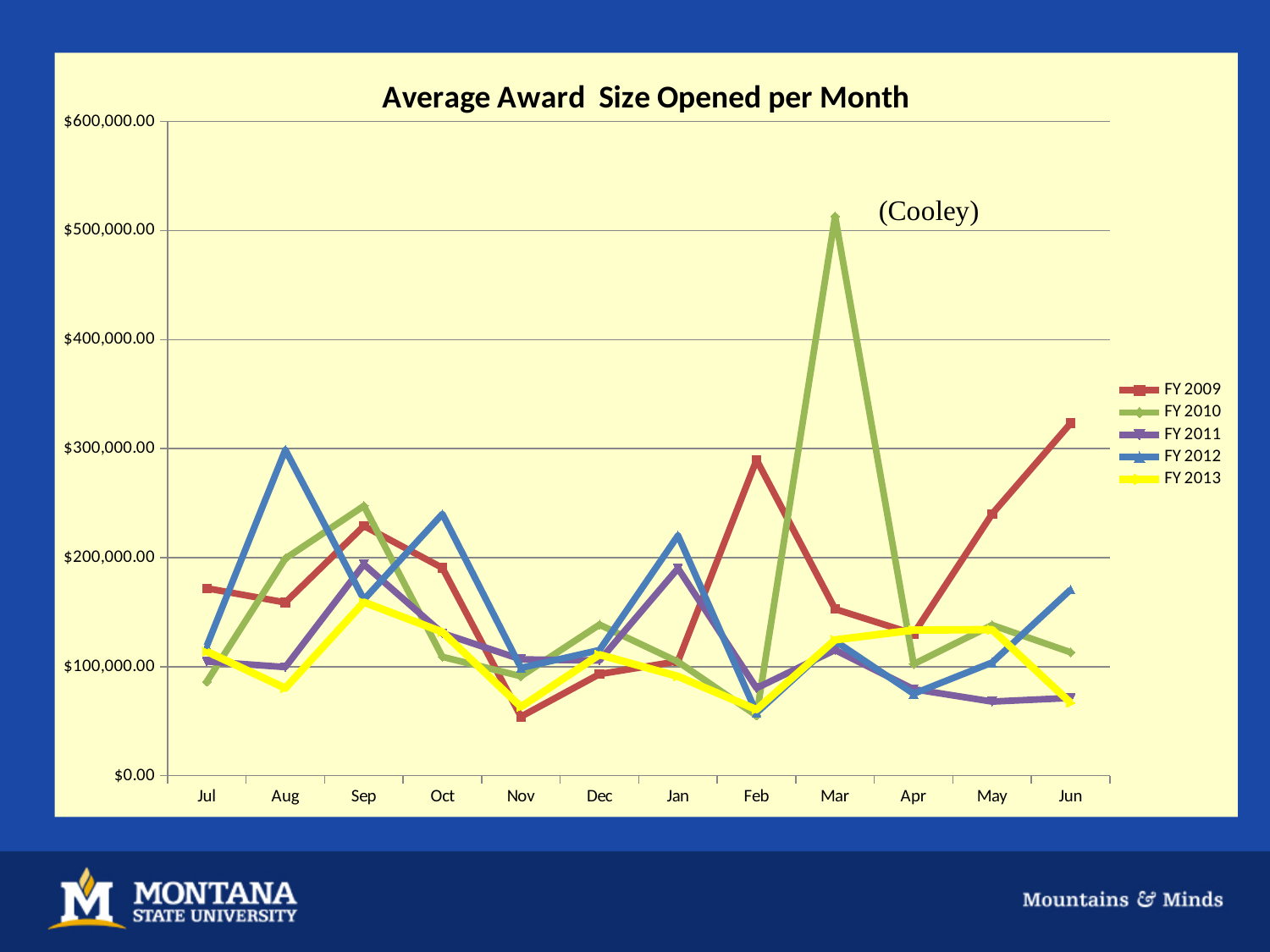
Is the FY 2010 value for Mar greater or less than $400,000.00? greater Which series reaches the highest value anywhere on the chart? FY 2010 What kind of chart is shown on the slide? line chart In which month does the FY 2010 series reach its highest value? Mar In Feb, which series has the larger value, FY 2009 or FY 2012? FY 2009 How many months are shown along the x axis? 12 What is the title of the chart? Average Award Size Opened per Month How many series does the legend list? 5 Does the FY 2009 series rise or fall from Apr to Jun? rise What annotation text appears next to the tallest peak on the chart? (Cooley) In which month is the FY 2009 value lowest? Nov Is the FY 2009 value for Nov greater or less than $100,000.00? less